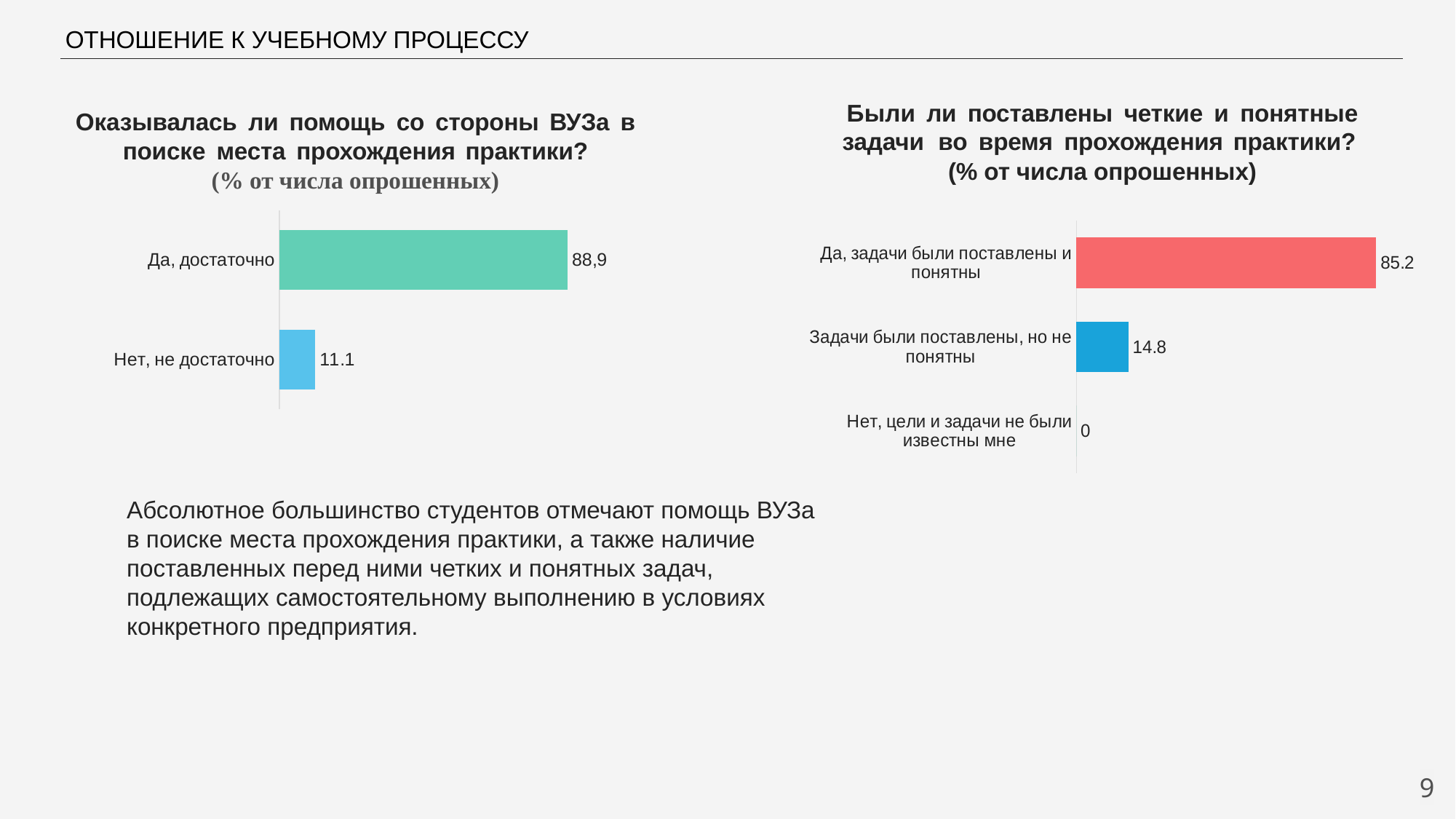
In the right chart (Были ли поставлены четкие и понятные задачи во время прохождения практики?), how many categories are shown? 3 In the left chart (Оказывалась ли помощь со стороны ВУЗа в поиске места прохождения практики?), how many categories are shown? 2 In the left chart (Оказывалась ли помощь со стороны ВУЗа в поиске места прохождения практики?), what is the value for 'Нет, не достаточно'? 11.1 In the left chart (Оказывалась ли помощь со стороны ВУЗа в поиске места прохождения практики?), what type of chart is used? Bar chart In the left chart (Оказывалась ли помощь со стороны ВУЗа в поиске места прохождения практики?), which category has the highest value? Да, достаточно In the right chart (Были ли поставлены четкие и понятные задачи во время прохождения практики?), which is larger: 'Да, задачи были поставлены и понятны' or 'Задачи были поставлены, но не понятны'? Да, задачи были поставлены и понятны In the right chart (Были ли поставлены четкие и понятные задачи во время прохождения практики?), what is the difference between 'Да, задачи были поставлены и понятны' and 'Задачи были поставлены, но не понятны'? 70.4 In the right chart (Были ли поставлены четкие и понятные задачи во время прохождения практики?), what is the value for 'Да, задачи были поставлены и понятны'? 85.2 In the right chart (Были ли поставлены четкие и понятные задачи во время прохождения практики?), what is the value for 'Нет, цели и задачи не были известны мне'? 0 In the right chart (Были ли поставлены четкие и понятные задачи во время прохождения практики?), which category has the lowest value? Нет, цели и задачи не были известны мне In the right chart (Были ли поставлены четкие и понятные задачи во время прохождения практики?), what is the value for 'Задачи были поставлены, но не понятны'? 14.8 In the left chart (Оказывалась ли помощь со стороны ВУЗа в поиске места прохождения практики?), what is the value for 'Да, достаточно'? 88,9